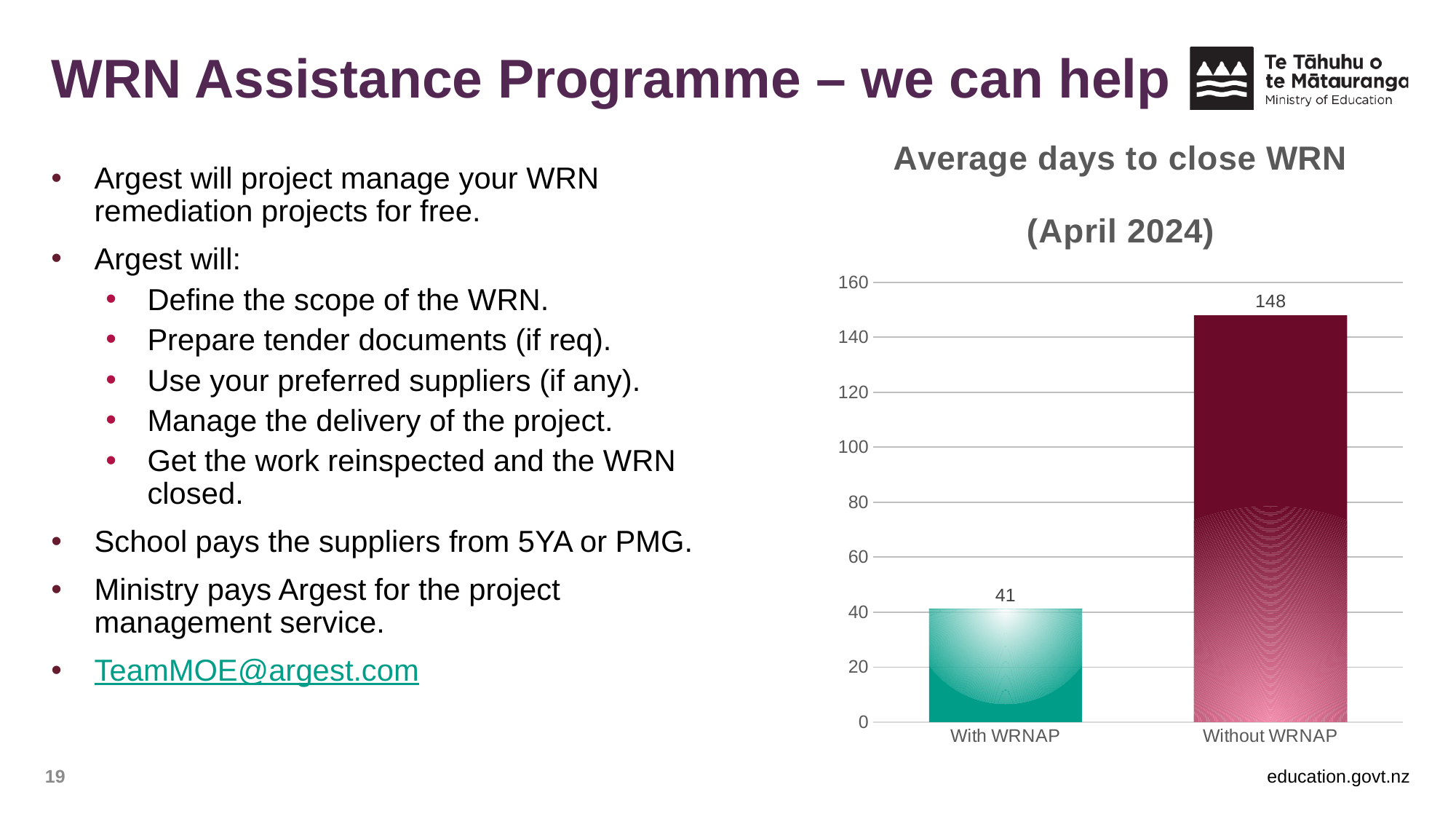
Which is larger: the average days to close WRN with WRNAP or without WRNAP? Without WRNAP Which category has the highest average days to close WRN? Without WRNAP What is the maximum value shown on the chart's vertical axis? 160 Is the value for With WRNAP greater or less than 60? less How many categories are shown in the chart? 2 Is the value for Without WRNAP greater or less than 140? greater What is the title of the chart? Average days to close WRN (April 2024) What is the average days to close WRN without WRNAP? 148 What kind of chart is shown on the slide? Bar chart What is the average days to close WRN with WRNAP? 41 Which category has the lowest average days to close WRN? With WRNAP What is the difference in average days to close WRN between Without WRNAP and With WRNAP? 107